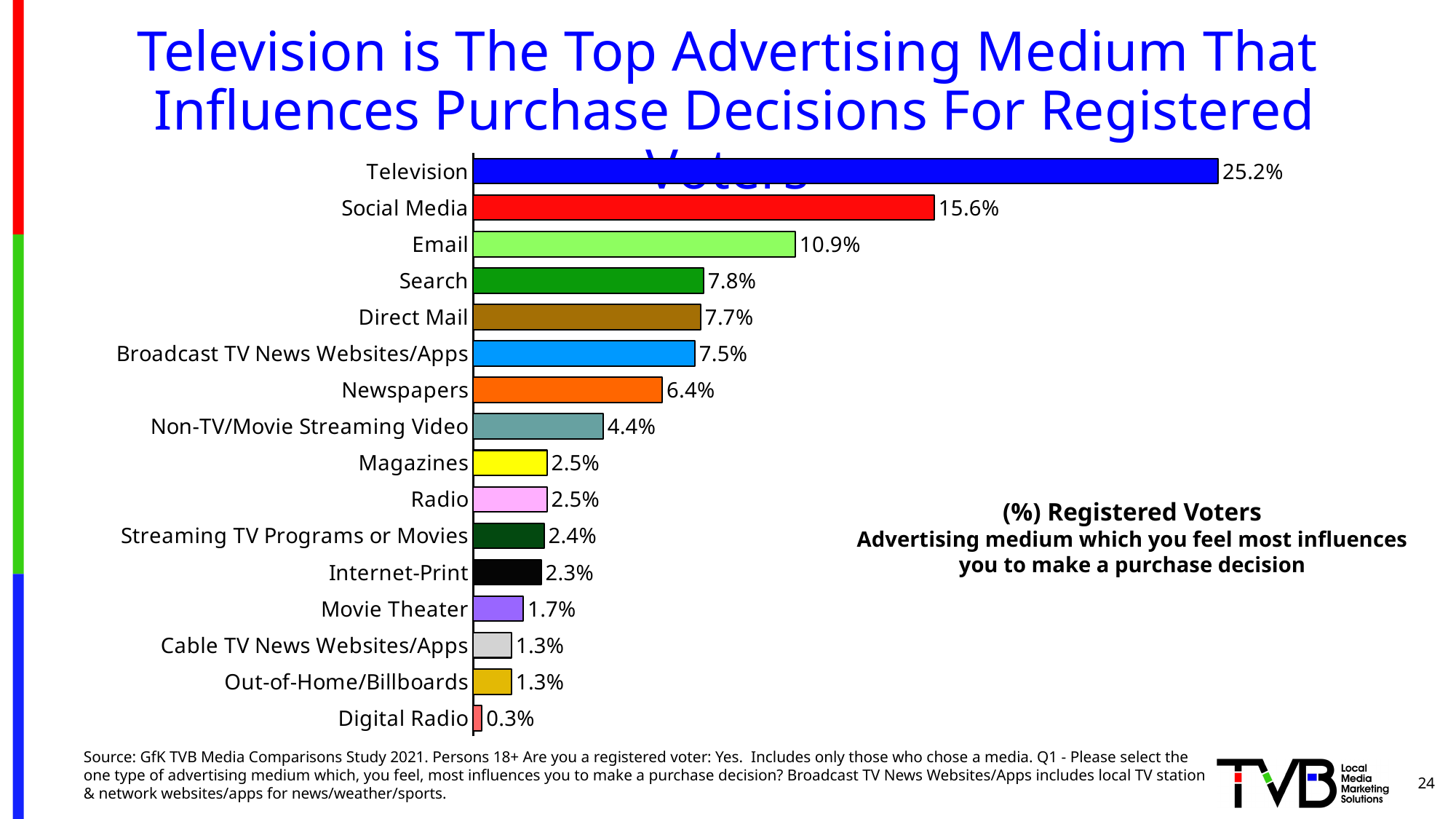
Which advertising medium has the highest value on the chart? Television What is the difference between the values for Email and Search? 3.1% Which advertising medium has the lowest value on the chart? Digital Radio What is the value shown for Broadcast TV News Websites/Apps? 7.5% What is the value shown for Digital Radio? 0.3% What colour is the bar for Social Media? Red How many advertising media categories are shown on the chart? 16 What is the difference between the values for Television and Social Media? 9.6% What kind of chart is shown on the slide? Bar chart Which has a larger value, Newspapers or Non-TV/Movie Streaming Video? Newspapers What is the value shown for Social Media? 15.6% What percentage of registered voters chose Television as the advertising medium that most influences their purchase decision? 25.2%